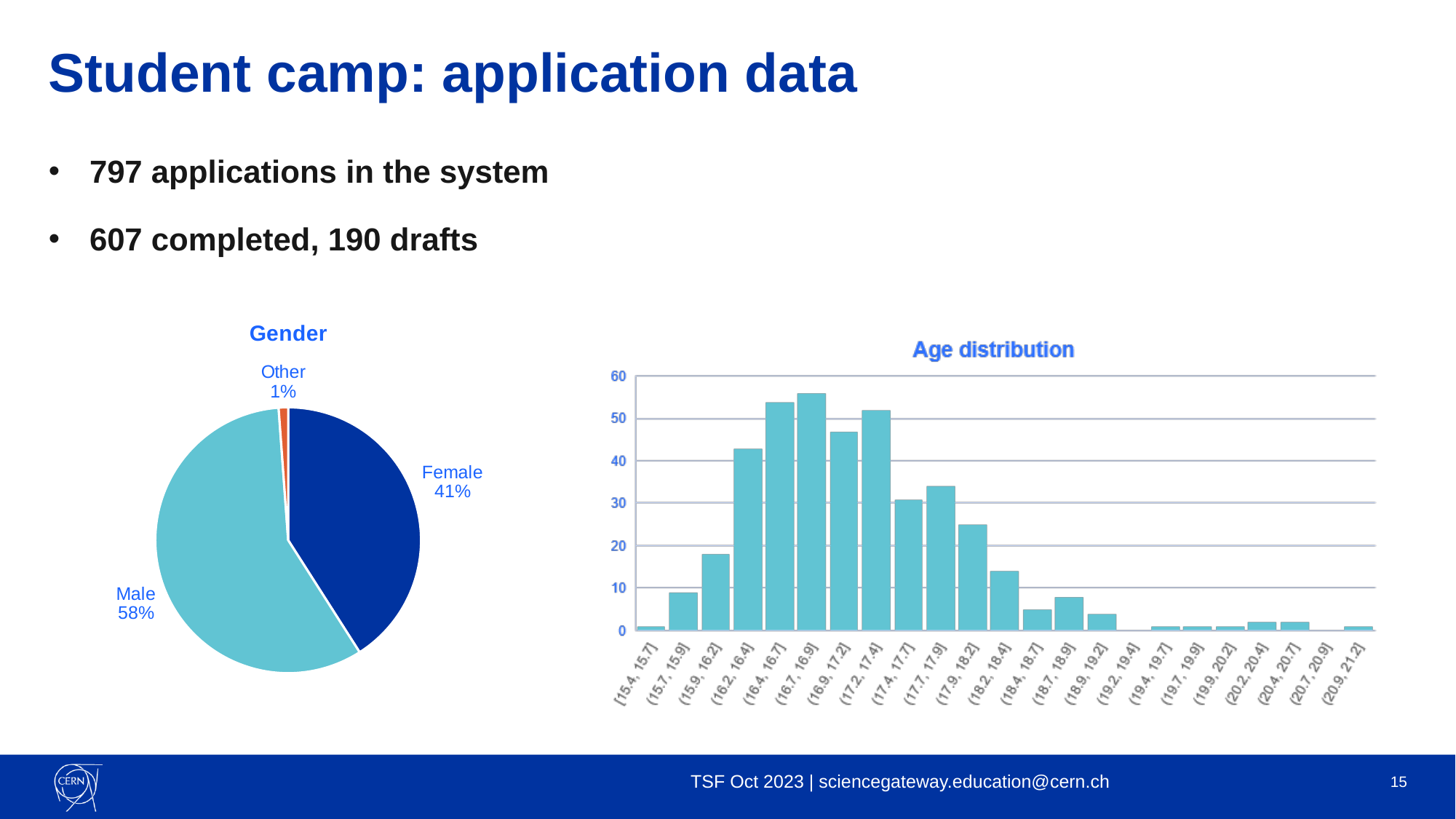
In the Age distribution chart, which bar is taller: (15.9, 16.2] or (17.9, 18.2]? (17.9, 18.2] In the Gender pie chart, which category has the smallest share? Other In the Age distribution chart, is the value for the (16.2, 16.4] bin greater or less than 40? greater In the Gender pie chart, what share of applicants are Male? 58% In the Gender pie chart, what share of applicants are Female? 41% In the Gender pie chart, what is the difference in percentage points between the Male and Female shares? 17 percentage points How many slices does the Gender pie chart have? 3 In the Gender pie chart, what share of applicants are listed as Other? 1% In the Age distribution chart, which age bin has the tallest bar? (16.7, 16.9] In the Age distribution chart, is the value for the (18.2, 18.4] bin greater or less than 20? less In the Gender pie chart, which category has the largest share? Male What kind of chart is the Age distribution chart? Bar chart